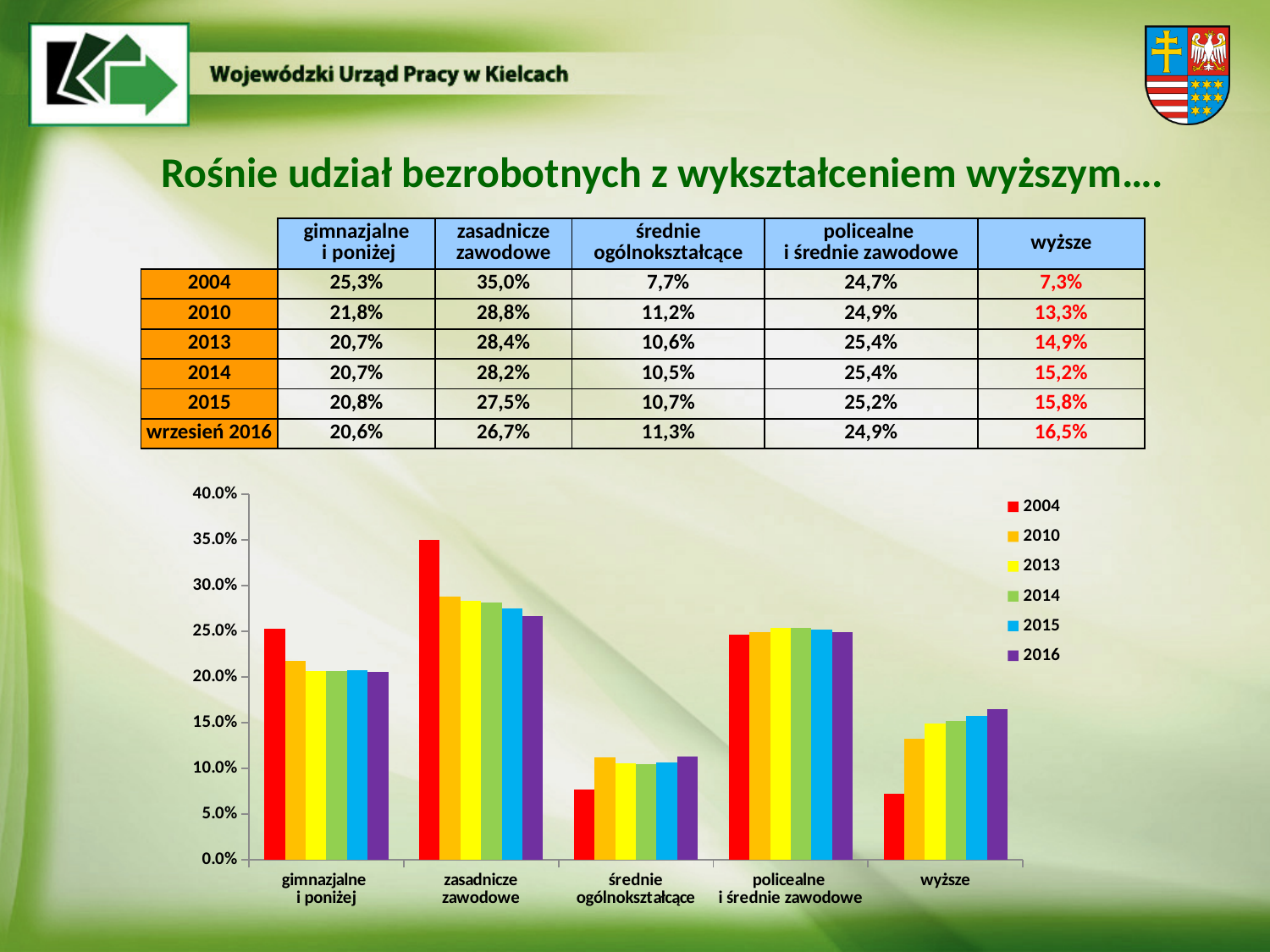
Is the 2004 value for 'zasadnicze zawodowe' greater or less than 30.0%? greater By how many percentage points did the share for 'wyższe' change between 2004 and wrzesień 2016? 9,2 pp How many education categories are shown on the x axis of the chart? 5 Which colour represents the 2004 series in the chart? red Do the bars for 'zasadnicze zawodowe' rise or fall from 2004 to 2016? fall What is the 2004 value for 'zasadnicze zawodowe'? 35,0% Is the 2016 value for 'wyższe' greater or less than 20.0%? less Which education category has the tallest bar for 2004? zasadnicze zawodowe What type of chart is shown on the slide? bar chart How many series does the chart legend list? 6 Do the bars for 'wyższe' rise or fall from 2004 to 2016? rise Which education category has the lowest bar for 2016? średnie ogólnokształcące